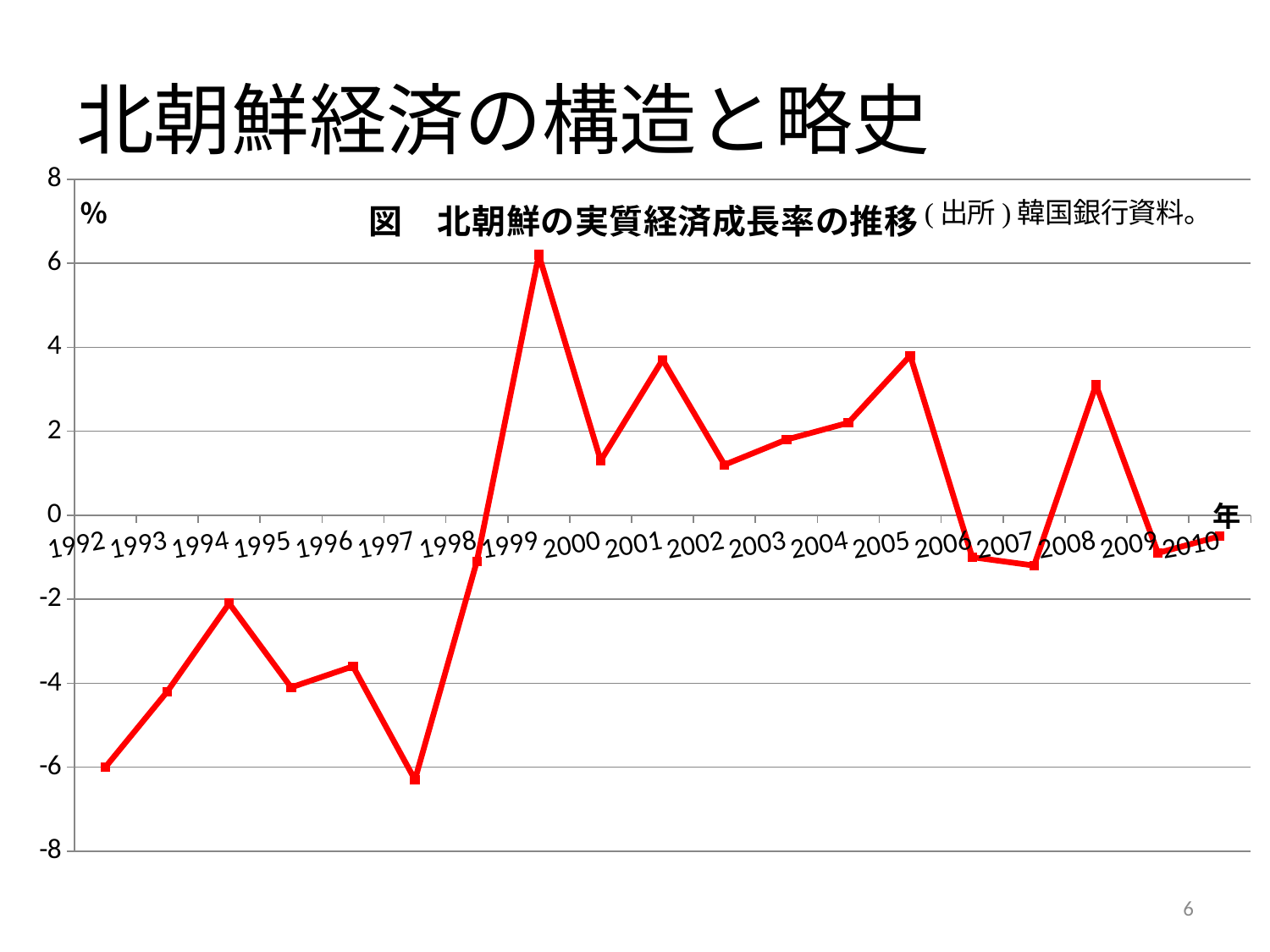
Does the growth rate rise or fall from 1992 to 1994? rise Which year has the lowest real economic growth rate on the chart? 1997 Which year has the higher value, 1999 or 2005? 1999 Is the value for 2000 greater or less than 2? less How many years are plotted on the chart? 19 What unit is shown on the vertical axis of the chart? % Is the value for 1992 greater or less than -4? less What is the title of the chart? 図 北朝鮮の実質経済成長率の推移 Which year has the highest real economic growth rate on the chart? 1999 Is the value for 1999 greater or less than 4? greater What kind of chart is shown on the slide? line chart